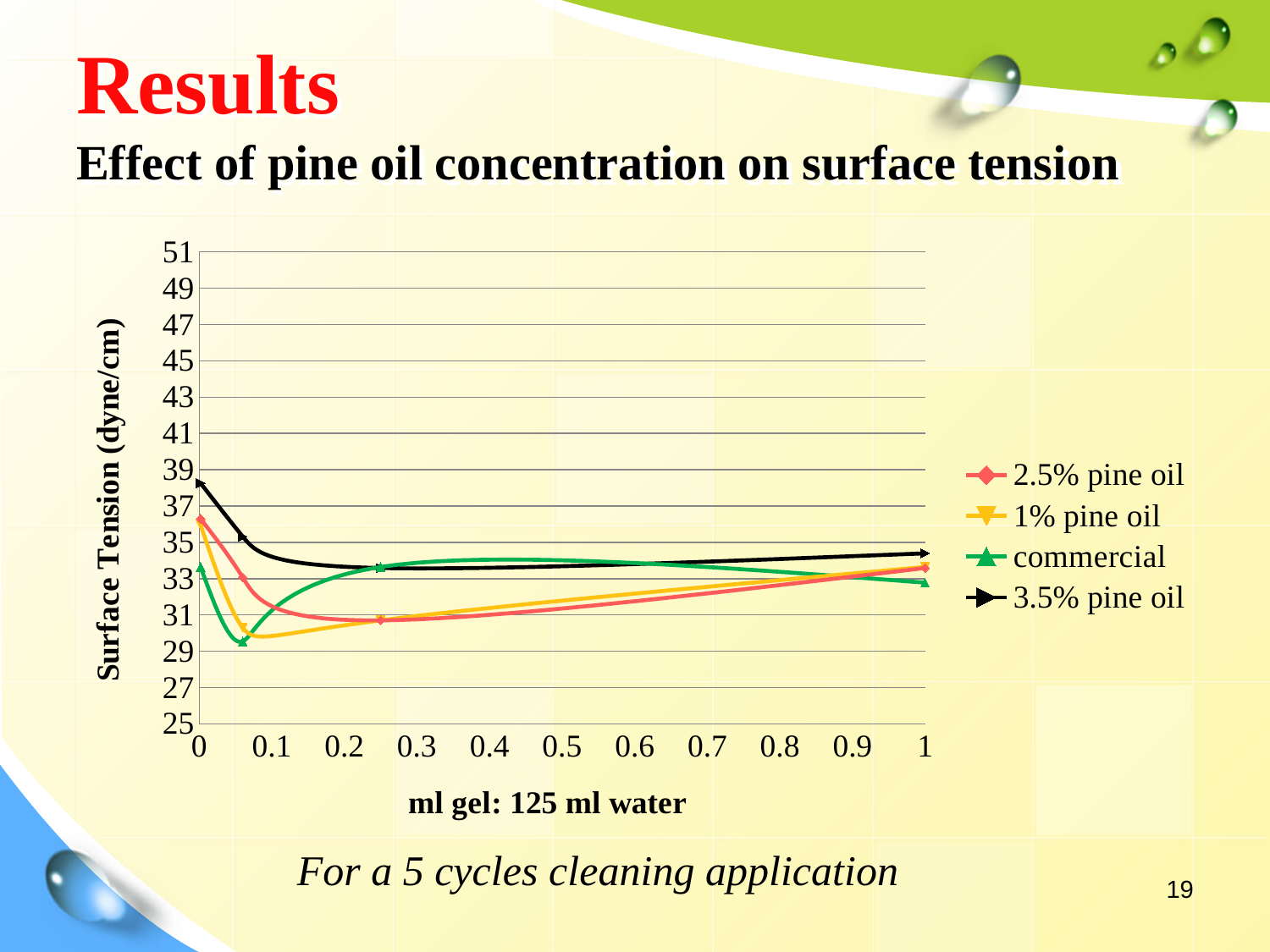
Which series has the lowest surface tension at 0 ml gel? commercial What is the label of the x axis? ml gel: 125 ml water Does the surface tension for 3.5% pine oil rise or fall between 0 and 0.25 ml gel? fall How many series does the legend list? 4 At 0.25 ml gel, which is larger: the surface tension for 3.5% pine oil or for 2.5% pine oil? 3.5% pine oil What is the label of the y axis? Surface Tension (dyne/cm) Which series has the highest surface tension at 0 ml gel? 3.5% pine oil Is the surface tension for 2.5% pine oil at 0.25 ml gel greater or less than 33? less Is the surface tension for 2.5% pine oil at 0 ml gel greater or less than 35? greater Is the surface tension for commercial at about 0.06 ml gel greater or less than 31? less What kind of chart is shown on the slide? line chart